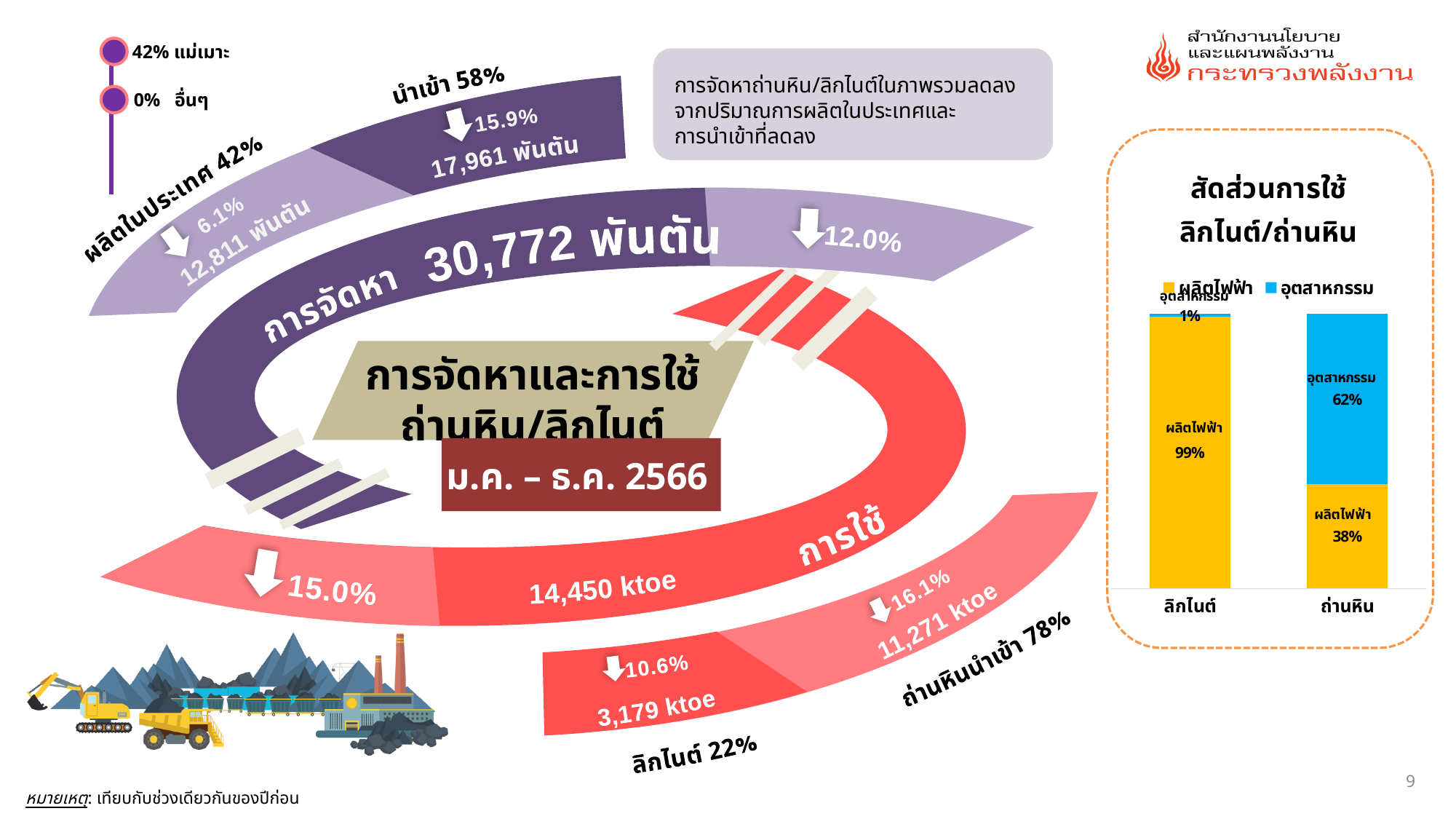
In the chart titled สัดส่วนการใช้ลิกไนต์/ถ่านหิน, what is the difference between the ผลิตไฟฟ้า share for ลิกไนต์ and the ผลิตไฟฟ้า share for ถ่านหิน? 61% In the chart titled สัดส่วนการใช้ลิกไนต์/ถ่านหิน, which category has the higher ผลิตไฟฟ้า share, ลิกไนต์ or ถ่านหิน? ลิกไนต์ In the chart titled สัดส่วนการใช้ลิกไนต์/ถ่านหิน, what is the total of the ลิกไนต์ stacked bar? 100% In the chart titled สัดส่วนการใช้ลิกไนต์/ถ่านหิน, what is the difference between the อุตสาหกรรม share and the ผลิตไฟฟ้า share in the ถ่านหิน bar? 24% In the chart titled สัดส่วนการใช้ลิกไนต์/ถ่านหิน, what is the value for ผลิตไฟฟ้า in the ลิกไนต์ bar? 99% How many categories are shown on the x axis of the chart titled สัดส่วนการใช้ลิกไนต์/ถ่านหิน? 2 How many series does the legend of the chart titled สัดส่วนการใช้ลิกไนต์/ถ่านหิน list? 2 In the chart titled สัดส่วนการใช้ลิกไนต์/ถ่านหิน, what is the value for อุตสาหกรรม in the ถ่านหิน bar? 62% What kind of chart is the chart titled สัดส่วนการใช้ลิกไนต์/ถ่านหิน? Stacked bar chart In the chart titled สัดส่วนการใช้ลิกไนต์/ถ่านหิน, which category has the higher อุตสาหกรรม share, ลิกไนต์ or ถ่านหิน? ถ่านหิน In the chart titled สัดส่วนการใช้ลิกไนต์/ถ่านหิน, what is the value for อุตสาหกรรม in the ลิกไนต์ bar? 1% In the chart titled สัดส่วนการใช้ลิกไนต์/ถ่านหิน, what is the value for ผลิตไฟฟ้า in the ถ่านหิน bar? 38%